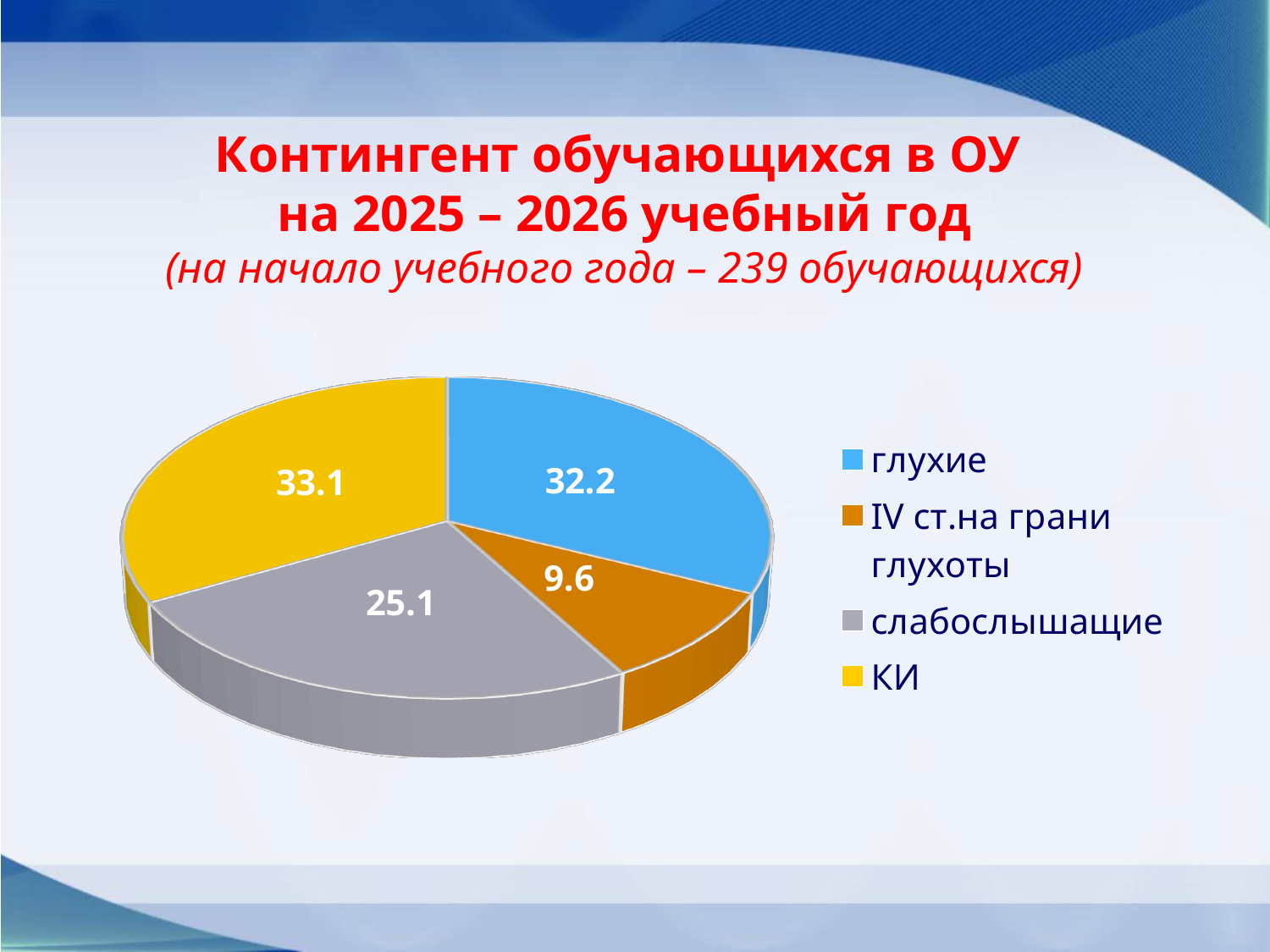
How many slices does the pie chart have? 4 What type of chart is shown on the slide? Pie chart What is the difference between the values for "слабослышащие" and "IV ст.на грани глухоты"? 15.5 What value is shown for the "IV ст.на грани глухоты" slice? 9.6 Which category has the largest slice of the pie? КИ What value is shown for the "глухие" slice? 32.2 What value is shown for the "слабослышащие" slice? 25.1 What is the difference between the values for "КИ" and "глухие"? 0.9 What colour is the "слабослышащие" slice? Gray Which category has the smallest slice of the pie? IV ст.на грани глухоты Which is larger, the value for "слабослышащие" or the value for "IV ст.на грани глухоты"? слабослышащие What value is shown for the "КИ" slice? 33.1